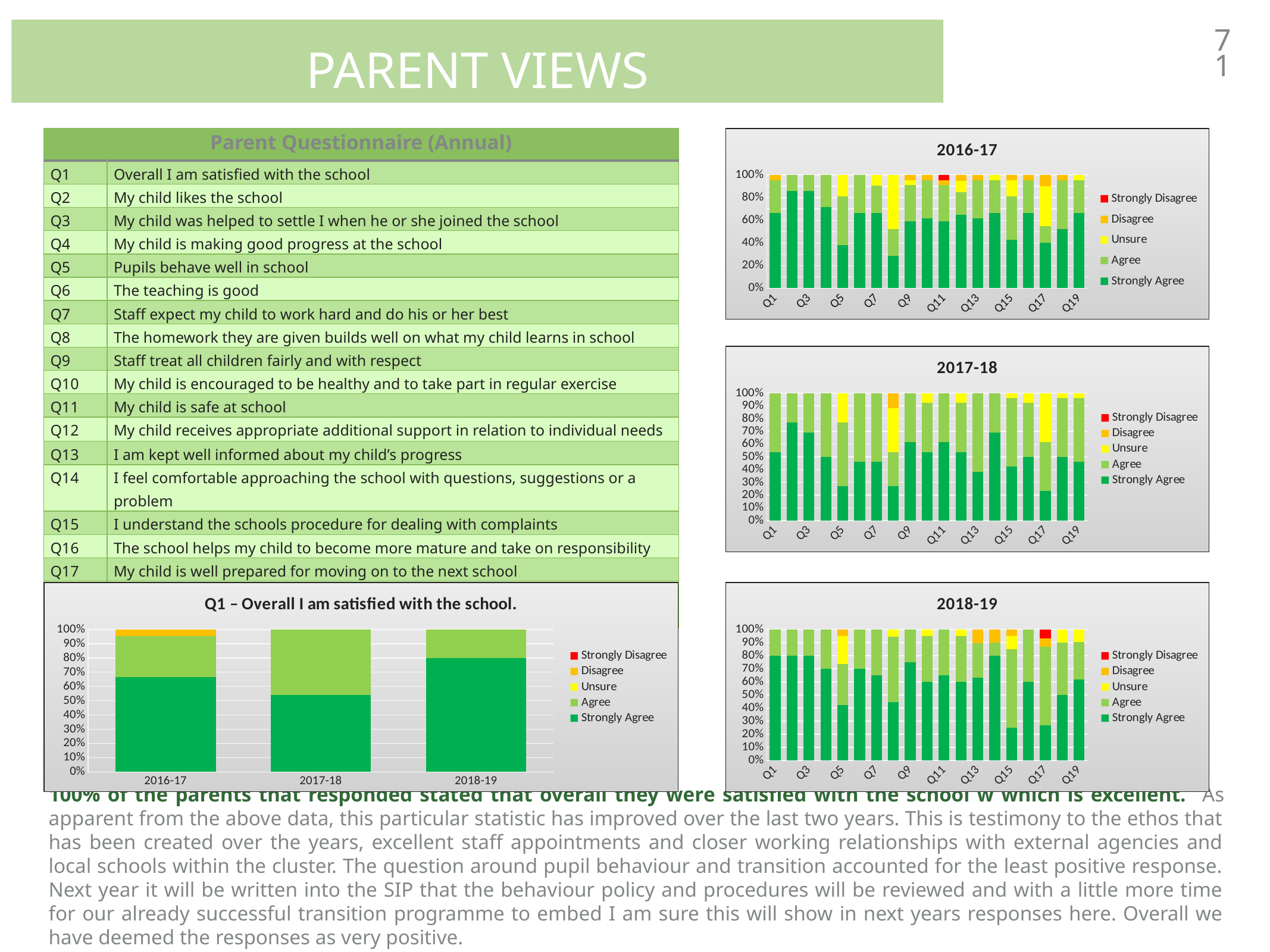
In the '2017-18' chart, is the Strongly Agree value for Q17 greater or less than 30%? less In the 'Q1 – Overall I am satisfied with the school.' chart, which year has the larger Strongly Agree share, 2016-17 or 2017-18? 2016-17 In the 'Q1 – Overall I am satisfied with the school.' chart, which year has the highest Strongly Agree share? 2018-19 In the '2018-19' chart, is the Strongly Agree value for Q5 greater or less than 50%? less In the '2016-17' chart, is the Strongly Agree value for Q2 greater or less than 80%? greater What kind of chart is the 'Q1 – Overall I am satisfied with the school.' chart? Stacked bar chart How many series does the legend of the 'Q1 – Overall I am satisfied with the school.' chart list? 5 In the '2016-17' chart, which question has the lowest Strongly Agree share? Q8 How many categories are shown on the x axis of the 'Q1 – Overall I am satisfied with the school.' chart? 3 Which colour represents Unsure in the legend of the '2018-19' chart? Yellow